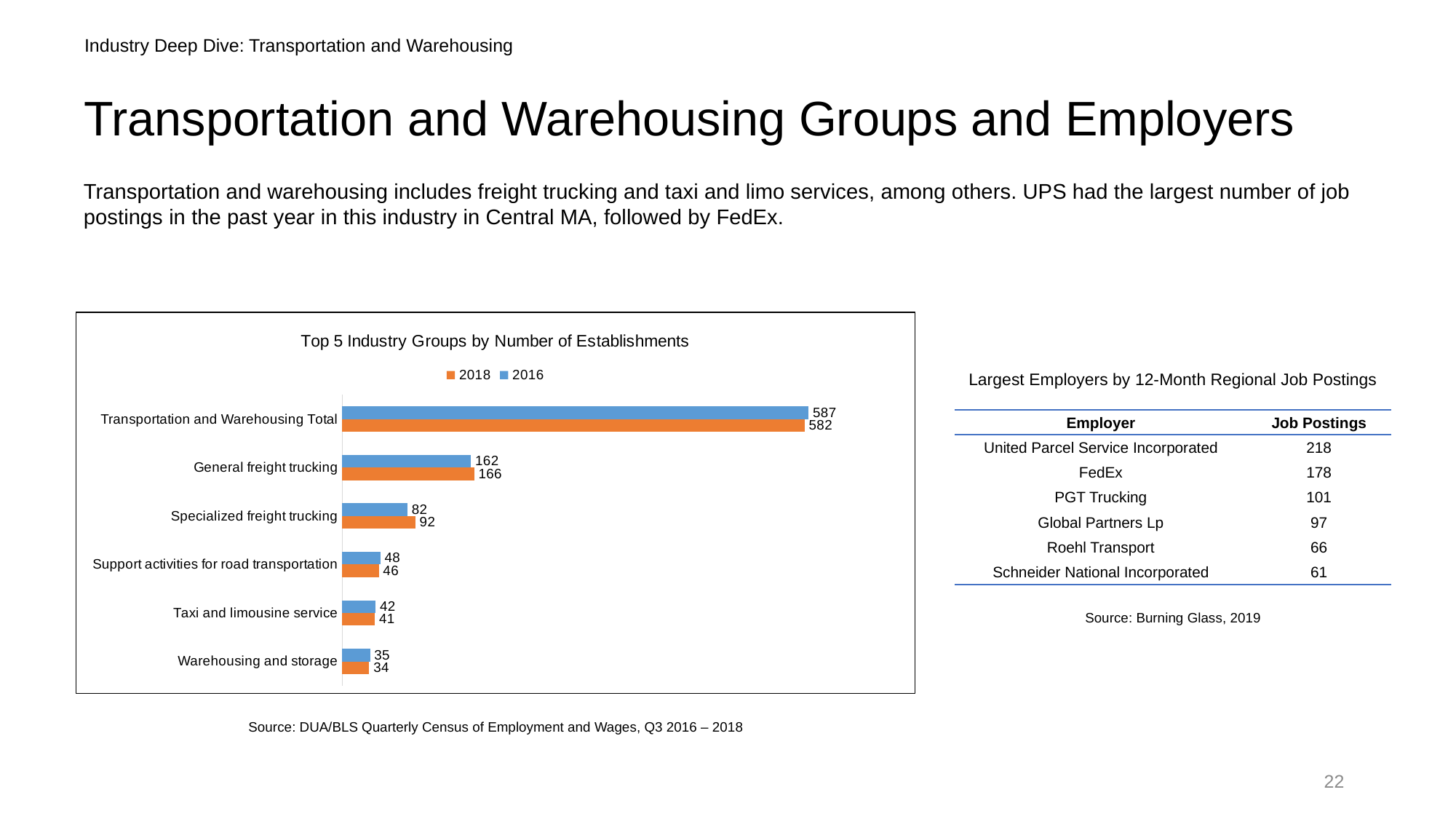
What is the 2018 value for Transportation and Warehousing Total in the chart? 582 Which colour represents the 2016 series in the Top 5 Industry Groups by Number of Establishments chart? blue Which category has the lowest 2018 value in the Top 5 Industry Groups by Number of Establishments chart? Warehousing and storage What is the difference between the 2018 and 2016 values for Specialized freight trucking in the chart? 10 What is the 2018 value for General freight trucking in the Top 5 Industry Groups by Number of Establishments chart? 166 What type of chart is the Top 5 Industry Groups by Number of Establishments chart? bar chart In the chart, is the 2018 value for Support activities for road transportation larger or smaller than its 2016 value? smaller What is the difference between the 2016 and 2018 values for Transportation and Warehousing Total in the chart? 5 How many series does the legend of the Top 5 Industry Groups by Number of Establishments chart list? 2 Excluding the Transportation and Warehousing Total, which industry group has the highest 2016 value in the chart? General freight trucking What is the 2016 value for Specialized freight trucking in the Top 5 Industry Groups by Number of Establishments chart? 82 How many industry group categories are shown in the Top 5 Industry Groups by Number of Establishments chart? 6